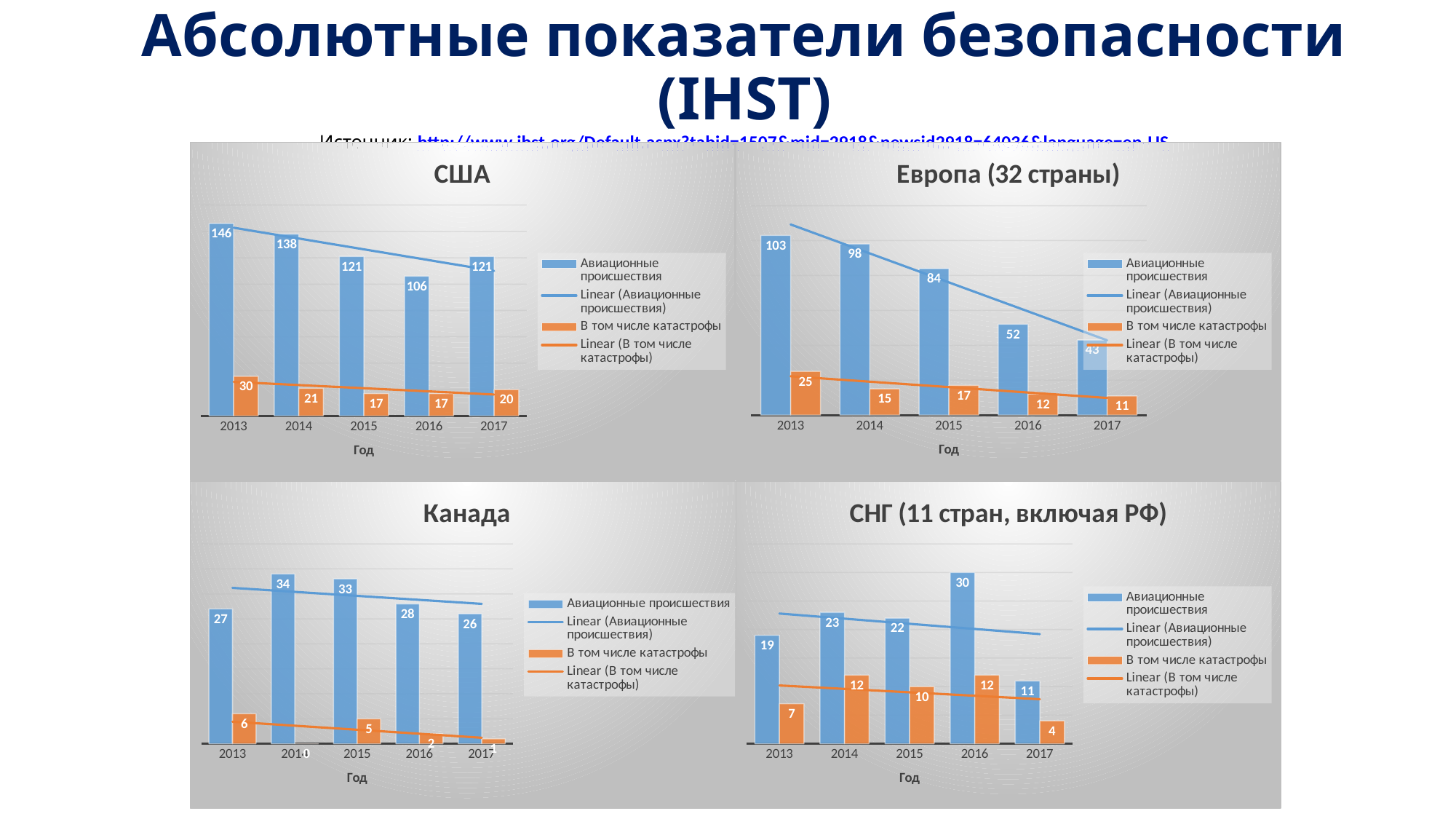
In the Европа (32 страны) chart, which year has the highest value of В том числе катастрофы? 2013 In the Канада chart, which is larger: Авиационные происшествия in 2013 or in 2017? 2013 In the США chart, which year has the lowest value of Авиационные происшествия? 2016 How many years are shown on the x axis of the СНГ (11 стран, включая РФ) chart? 5 What type of chart is the США chart? bar chart In the США chart, what is the difference between Авиационные происшествия in 2013 and 2017? 25 In the Канада chart, what is the value of Авиационные происшествия for 2014? 34 In the СНГ (11 стран, включая РФ) chart, which year has the highest value of Авиационные происшествия? 2016 In the Европа (32 страны) chart, what is the value of В том числе катастрофы for 2016? 12 In the СНГ (11 стран, включая РФ) chart, what is the difference between Авиационные происшествия and В том числе катастрофы in 2017? 7 In the США chart, what is the value of Авиационные происшествия for 2013? 146 In the Европа (32 страны) chart, do the values of Авиационные происшествия rise or fall from 2013 to 2017? fall